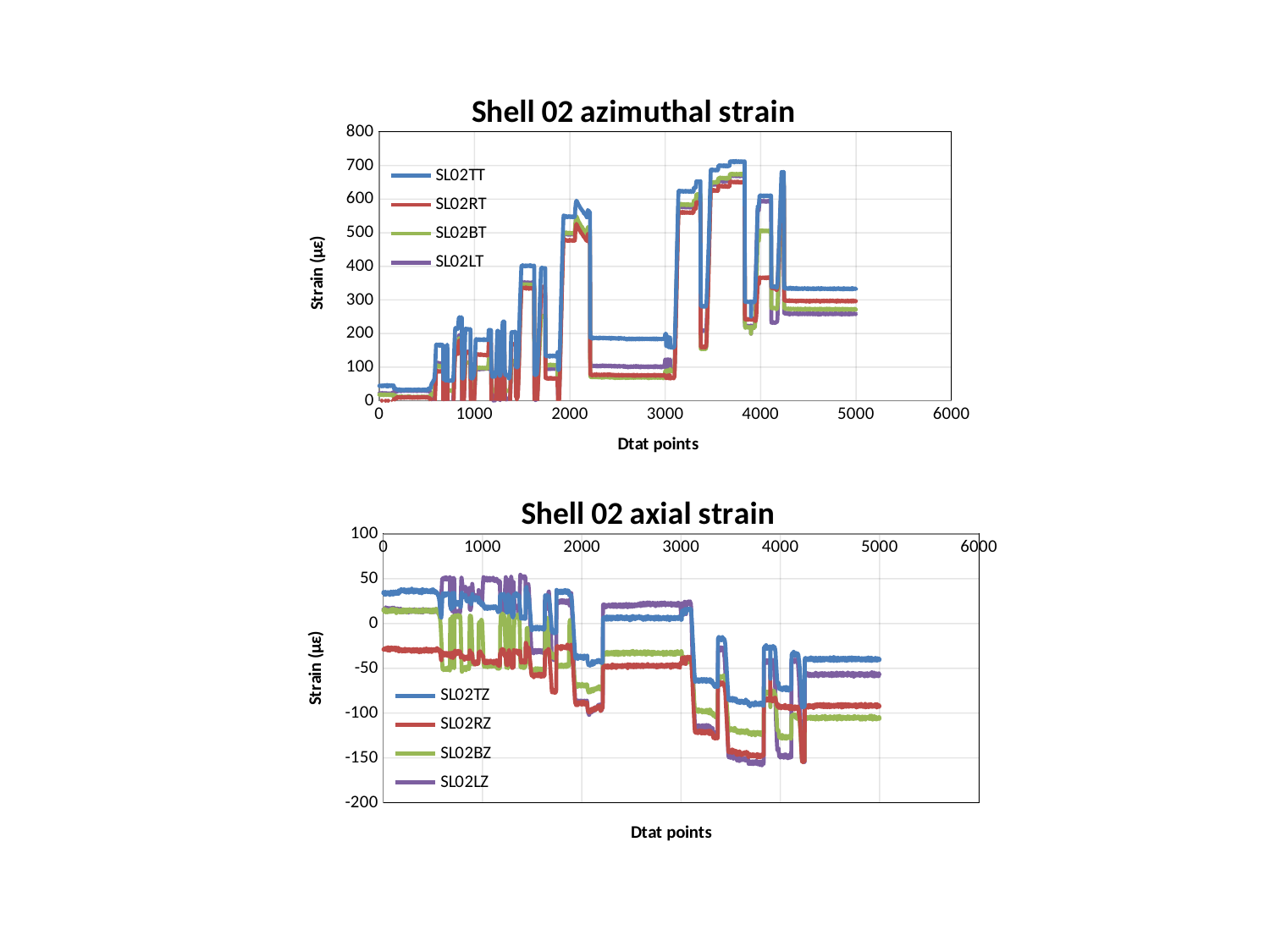
How many series does the legend of the 'Shell 02 axial strain' chart list? 4 What kind of chart is the 'Shell 02 azimuthal strain' chart? line chart What is the x-axis label of the 'Shell 02 axial strain' chart? Dtat points In the 'Shell 02 axial strain' chart, at 4500 data points, which is higher: SL02TZ or SL02BZ? SL02TZ In the 'Shell 02 azimuthal strain' chart, is the value of SL02BT at 2500 data points greater or less than 100? less In the 'Shell 02 axial strain' chart, do the values of SL02BZ generally rise or fall along the x axis? fall In the 'Shell 02 azimuthal strain' chart, which series is drawn in blue? SL02TT In the 'Shell 02 axial strain' chart, is the value of SL02RZ at 2500 data points greater or less than 0? less How many series does the legend of the 'Shell 02 azimuthal strain' chart list? 4 In the 'Shell 02 azimuthal strain' chart, is the value of SL02TT at 2500 data points greater or less than 100? greater In the 'Shell 02 azimuthal strain' chart, at 4500 data points, which is higher: SL02TT or SL02LT? SL02TT